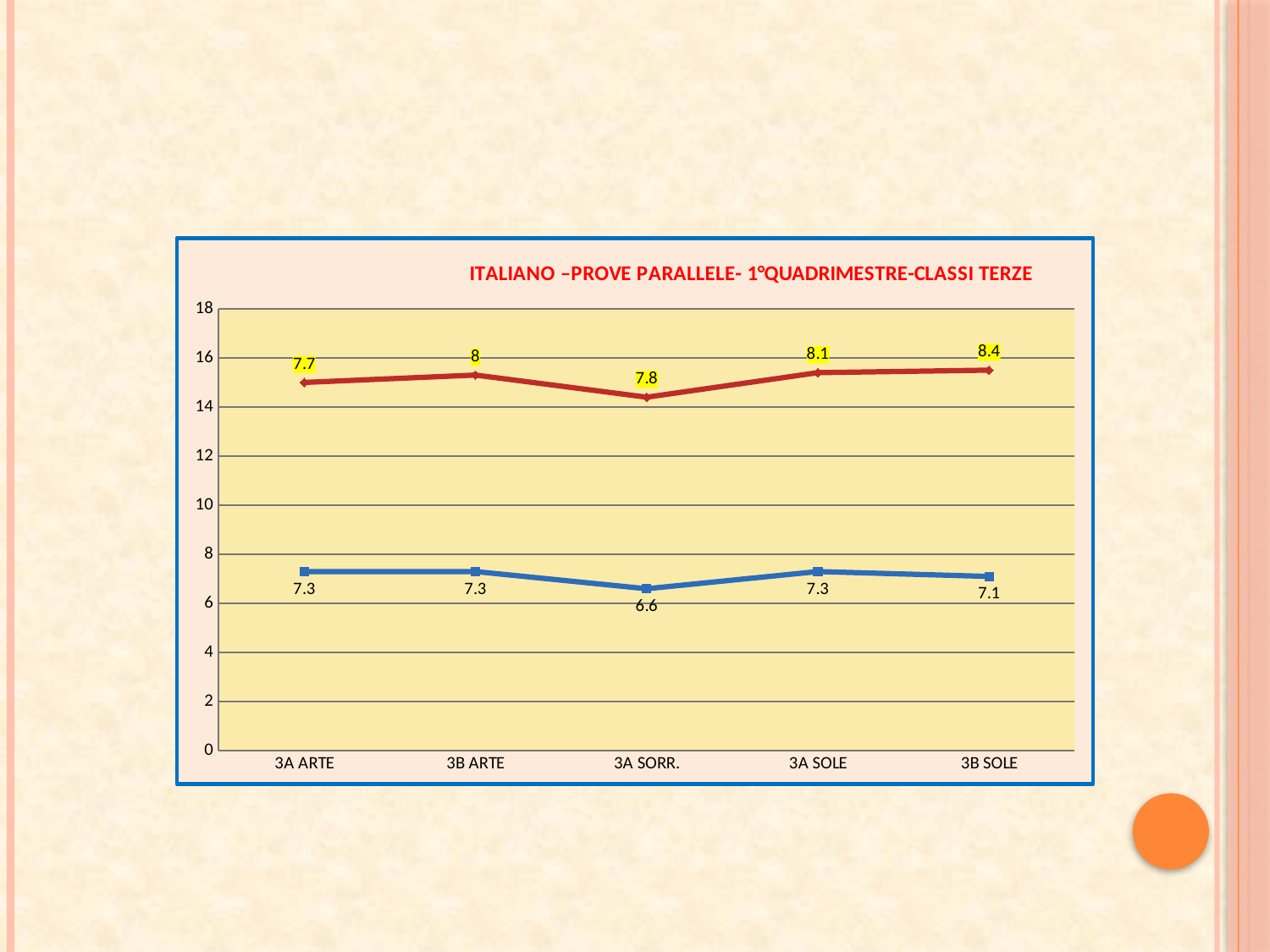
Is the plotted red line point for 3A SOLE above or below 14 on the y axis? above Which is larger on the blue line: the labelled value for 3A SOLE or for 3B SOLE? 3A SOLE How many lines are plotted on the chart? 2 What is the value labelled on the red line for 3B SOLE? 8.4 What is the value labelled on the blue line for 3A SORR.? 6.6 What is the difference between the red line's labelled values for 3B SOLE and 3A ARTE? 0.7 What is the title of the chart? ITALIANO –PROVE PARALLELE- 1°QUADRIMESTRE-CLASSI TERZE Which category has the highest labelled value on the red line? 3B SOLE How many categories are shown on the x axis of the chart? 5 Which category has the lowest labelled value on the blue line? 3A SORR. What type of chart is shown on the slide? line chart What is the value labelled on the red line for 3B ARTE? 8